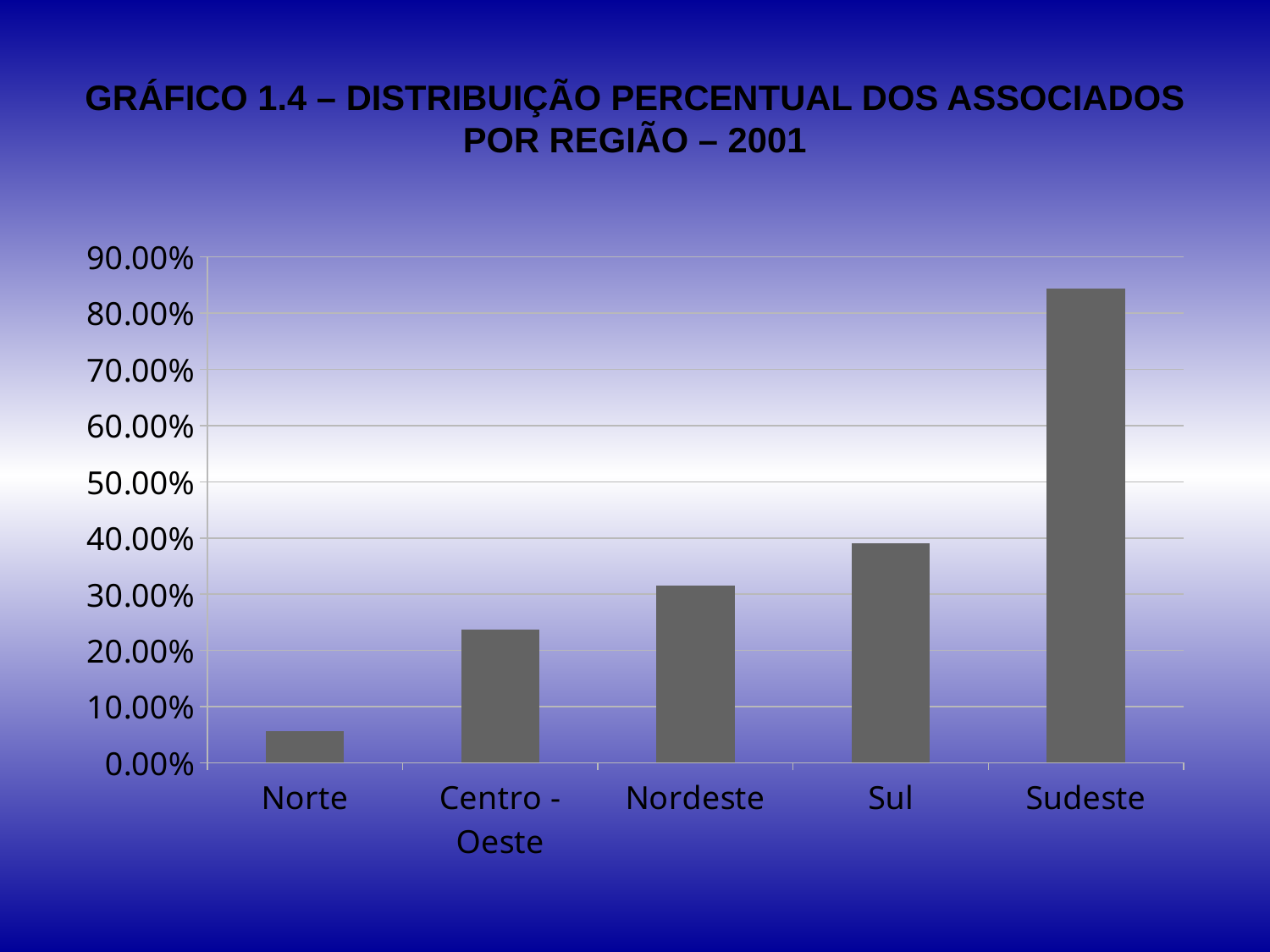
Is the value for Nordeste greater or less than 40.00%? less Which region has a larger value, Sul or Nordeste? Sul Which region has the highest percentage of associados? Sudeste Which region has the lowest percentage of associados? Norte What kind of chart is shown on the slide? bar chart Is the value for Sul greater or less than 30.00%? greater Is the value for Sudeste greater or less than 80.00%? greater How many regions are shown on the x axis of the chart? 5 Do the values rise or fall moving from Norte to Sudeste along the x axis? rise What year does the chart title refer to? 2001